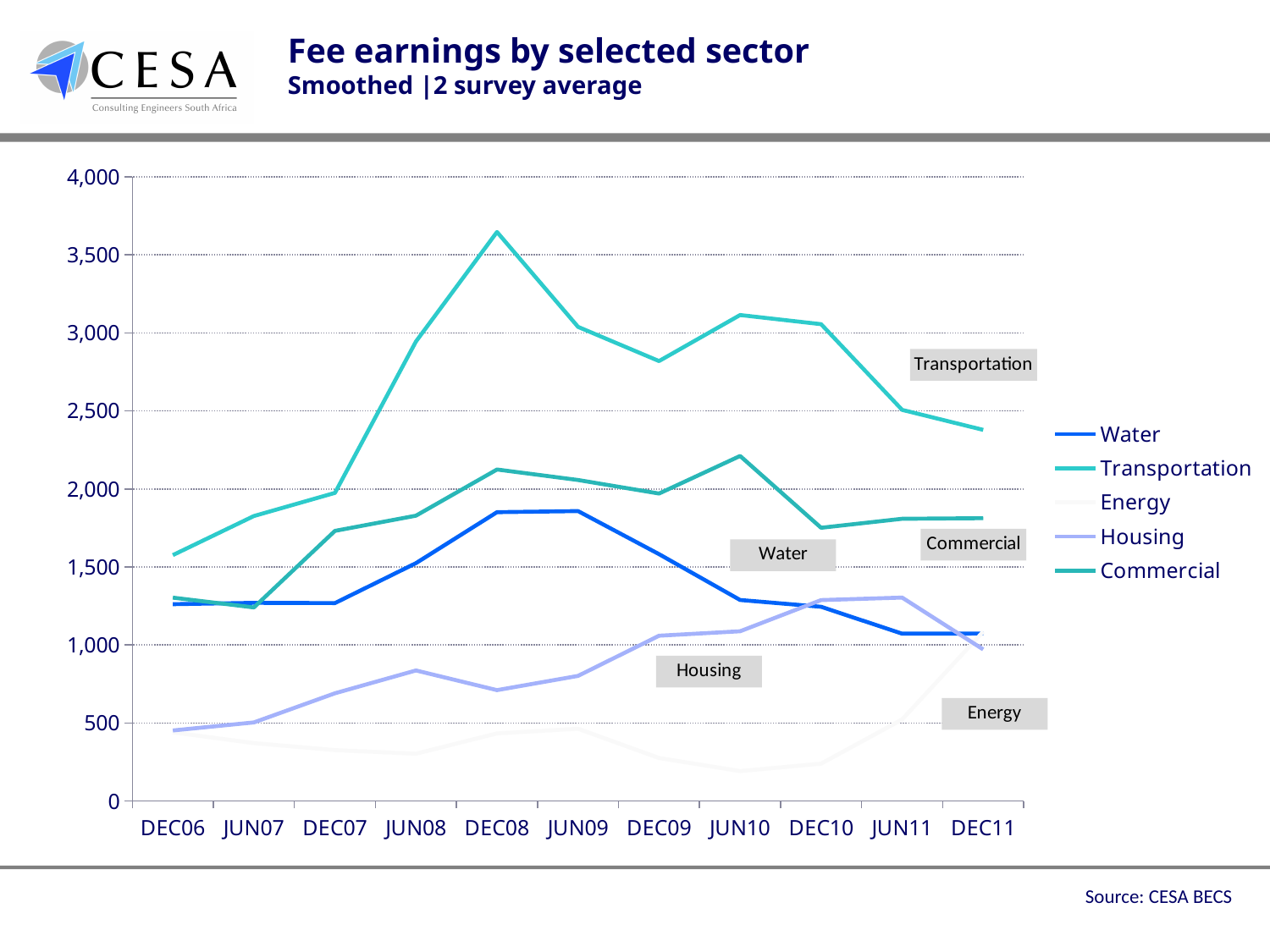
Does the Transportation line rise or fall from DEC06 to DEC08? rise Is the value for Commercial at JUN10 greater or less than 2,000? greater How many time points are shown along the x axis? 11 Is the value for Transportation at DEC11 greater or less than 2,500? less At DEC11, which is larger: Commercial or Water? Commercial How many series does the legend list? 5 What is the title of the chart? Fee earnings by selected sector Which series has the highest value at DEC08? Transportation Is the value for Transportation at DEC08 greater or less than 3,500? greater What kind of chart is shown on the slide? Line chart Which series has the lowest value at JUN10? Energy